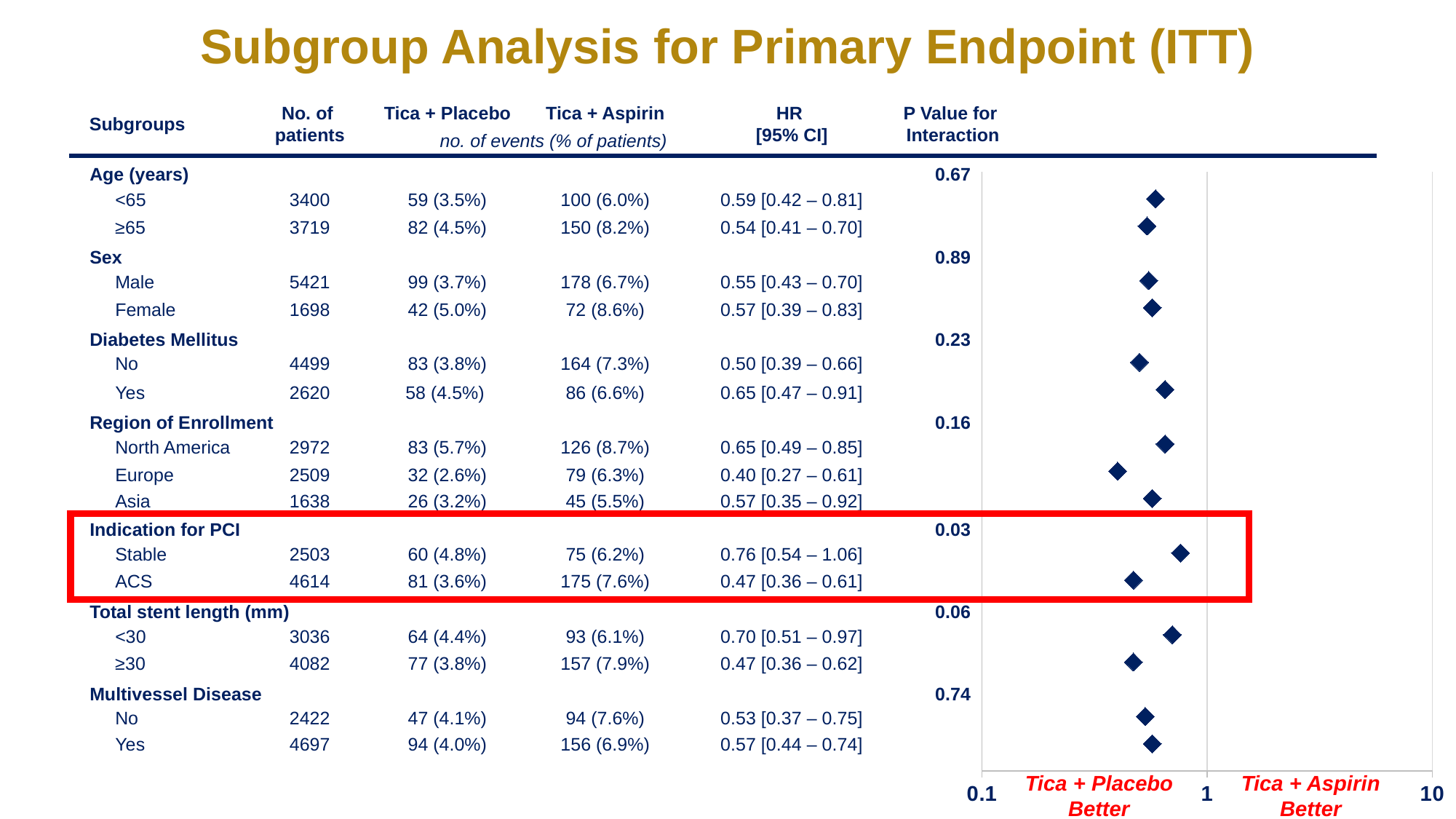
What is the hazard ratio [95% CI] for the Europe subgroup? 0.40 [0.27 – 0.61] How many subgroup points are plotted in the forest plot? 15 What is the P value for interaction for Indication for PCI? 0.03 Which treatment is labeled as better on the left side of the forest plot's x axis? Tica + Placebo Is the hazard ratio for the ACS subgroup greater or less than 1? less Which subgroup has the lowest hazard ratio? Europe What is the hazard ratio for the Stable indication for PCI subgroup? 0.76 What is the difference between the hazard ratios of the Stable and ACS subgroups? 0.29 Which has the larger hazard ratio, the Stable subgroup or the ACS subgroup? Stable What kind of chart is shown on the right side of the slide? Forest plot Which subgroup has the highest hazard ratio? Stable What are the minimum and maximum values shown on the x axis of the forest plot? 0.1 and 10